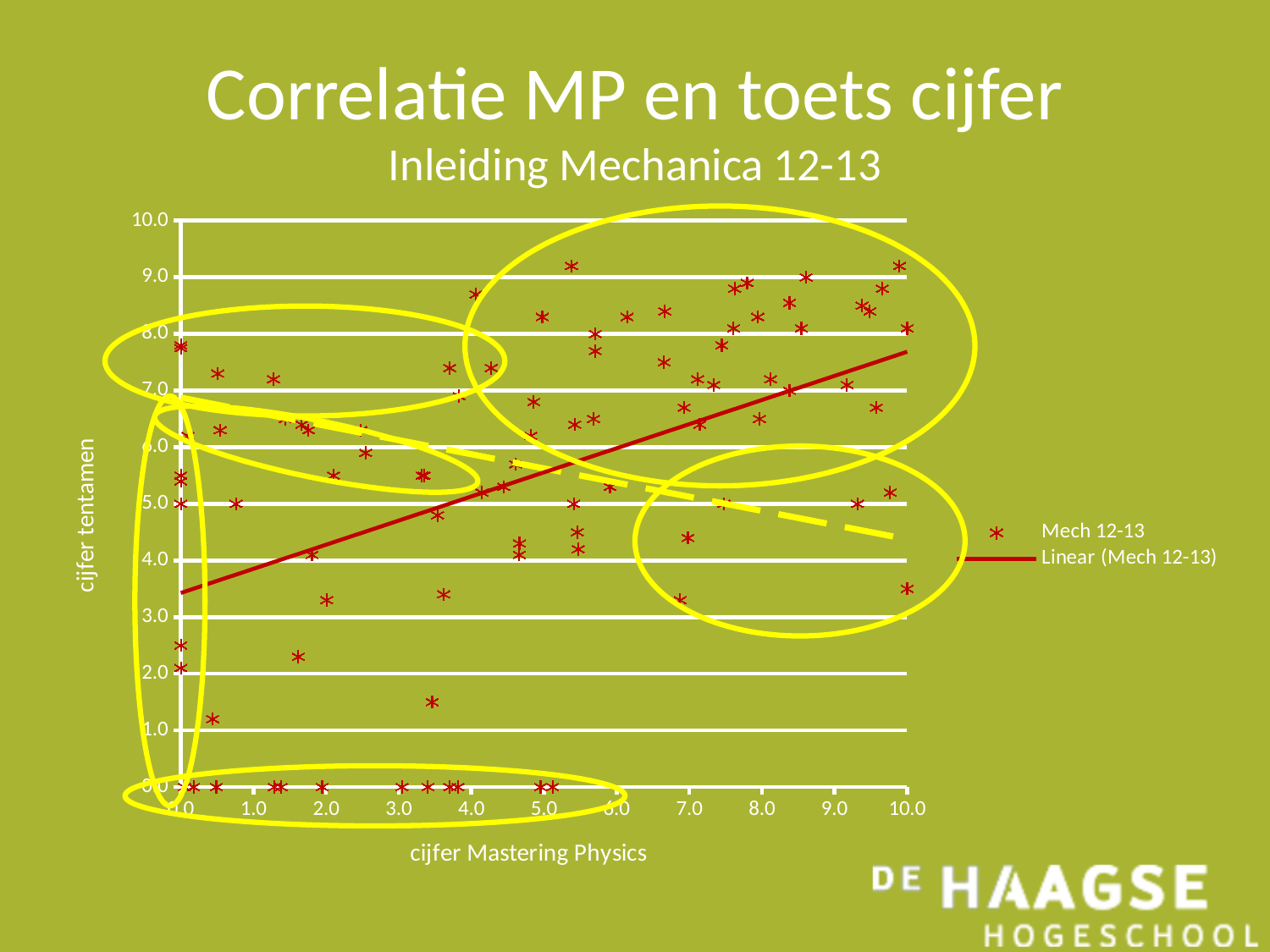
What is the label of the trendline entry in the legend? Linear (Mech 12-13) How many entries does the chart legend list? 2 What is the name of the data series in the legend? Mech 12-13 Does the linear trendline rise or fall as the cijfer Mastering Physics increases? rise What kind of chart is shown on the slide? scatter chart Is the value of the linear trendline at cijfer Mastering Physics 0.0 greater or less than 4.0? less What is the highest tick value shown on the horizontal axis? 10.0 Is the value of the linear trendline at cijfer Mastering Physics 10.0 greater or less than 7.0? greater What is the highest tick value shown on the vertical axis? 10.0